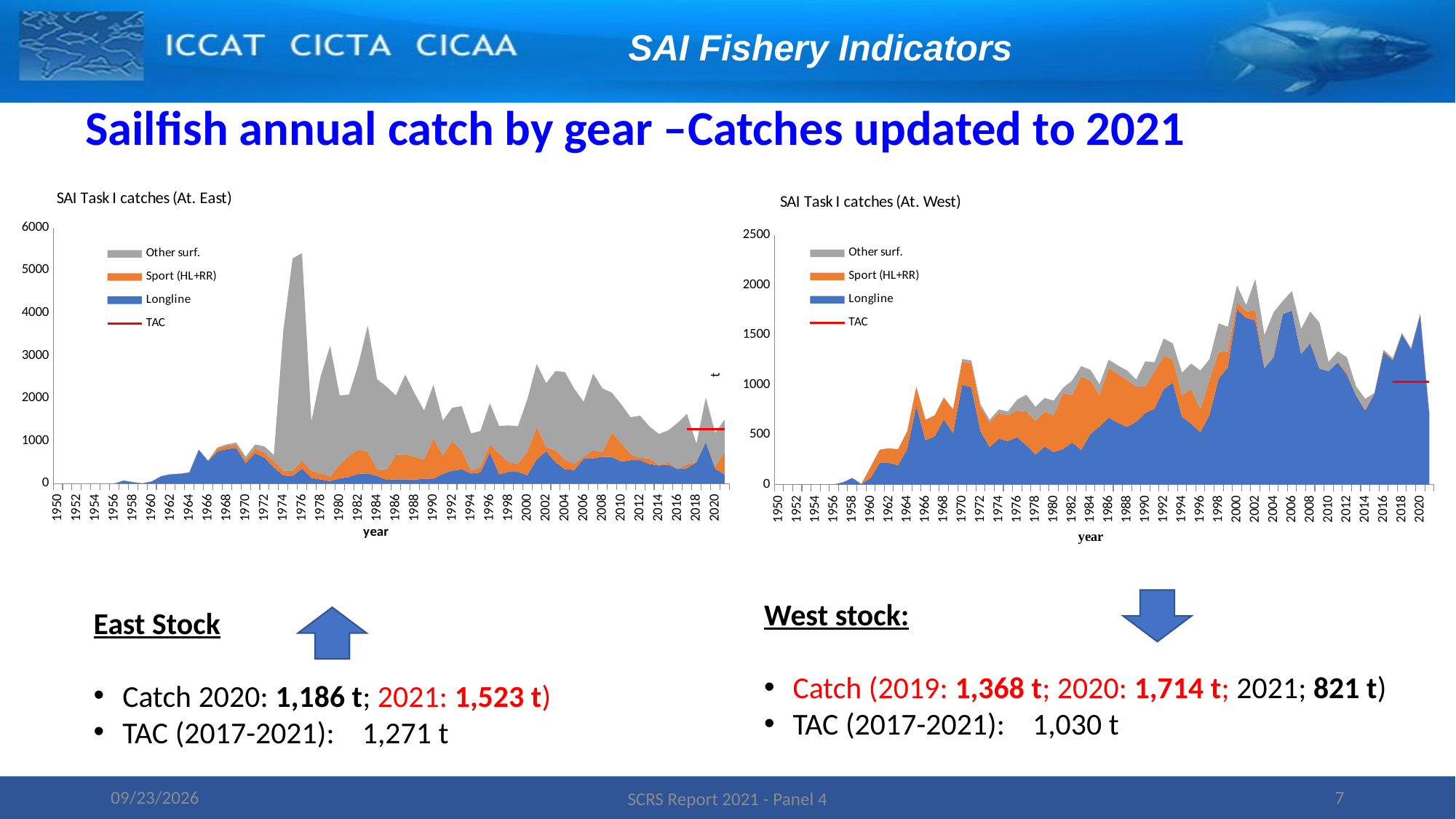
In the 'SAI Task I catches (At. West)' chart, is the total catch in 2020 greater or less than 1500? greater In the 'SAI Task I catches (At. West)' chart, does the total catch rise or fall from 2006 to 2014? fall In the 'SAI Task I catches (At. East)' chart, is the TAC line greater or less than 1000? greater In the 'SAI Task I catches (At. East)' chart, is the peak total catch around 1976 greater or less than 5000? greater Which colour represents Longline in the 'SAI Task I catches (At. East)' chart? blue How many entries does the legend of the 'SAI Task I catches (At. West)' chart list? 4 What kind of chart is the 'SAI Task I catches (At. East)' chart? area chart What is the highest value shown on the y axis of the 'SAI Task I catches (At. West)' chart? 2500 In the 'SAI Task I catches (At. East)' chart, which year shows the highest total catch? 1976